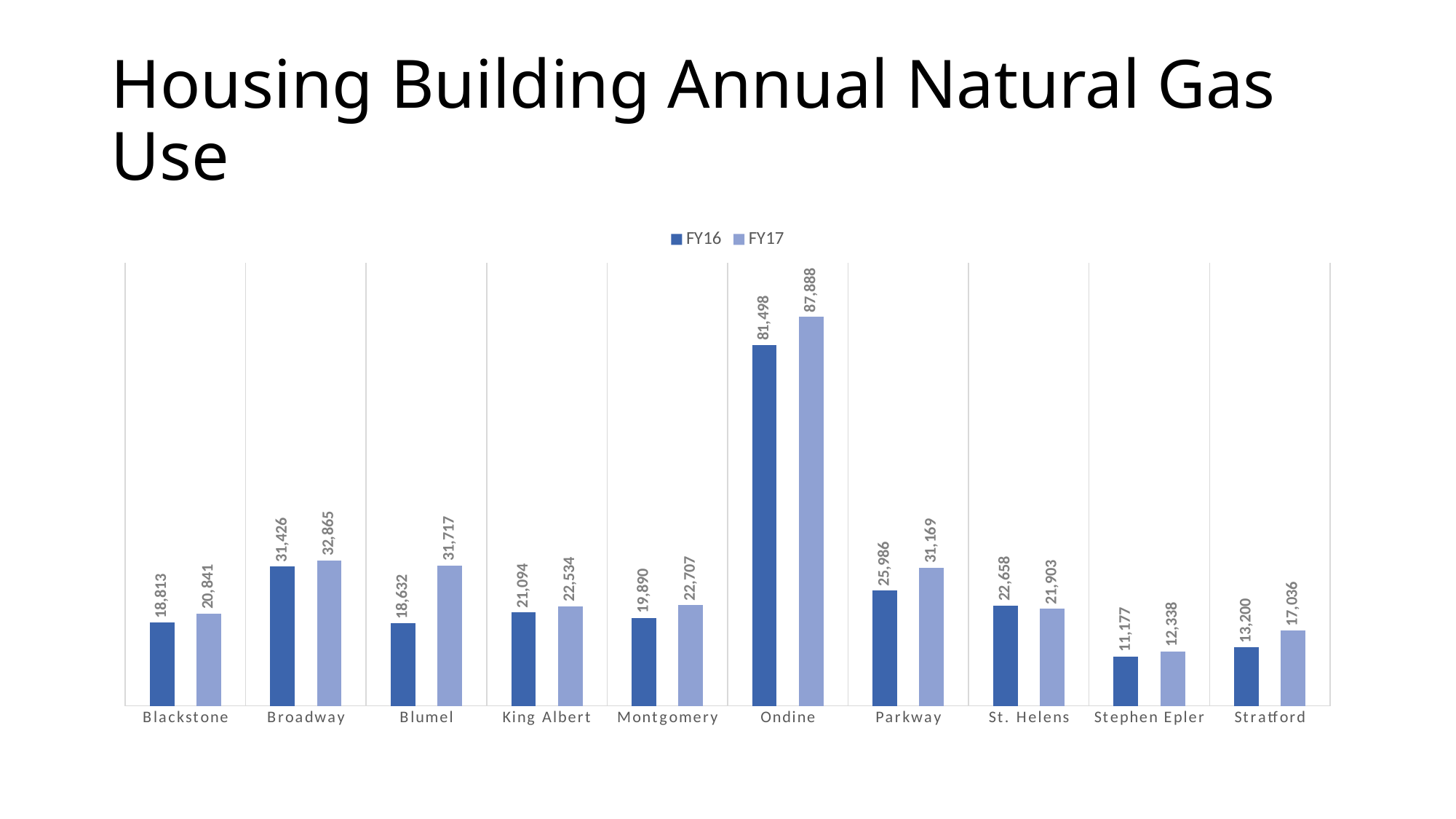
Which is larger for St. Helens, the FY16 value or the FY17 value? FY16 Which building has the highest FY17 value? Ondine What is the FY17 value for Stratford? 17,036 What is the FY16 value for Ondine? 81,498 How many buildings are shown on the x axis? 10 How many series does the legend list? 2 What is the FY16 value for Parkway? 25,986 What is the difference between the FY17 and FY16 values for Ondine? 6,390 What is the difference between the FY17 and FY16 values for Blumel? 13,085 Which is larger, the FY17 value for Broadway or the FY17 value for Parkway? Broadway What kind of chart is shown on the slide? Bar chart Which building has the lowest FY16 value? Stephen Epler